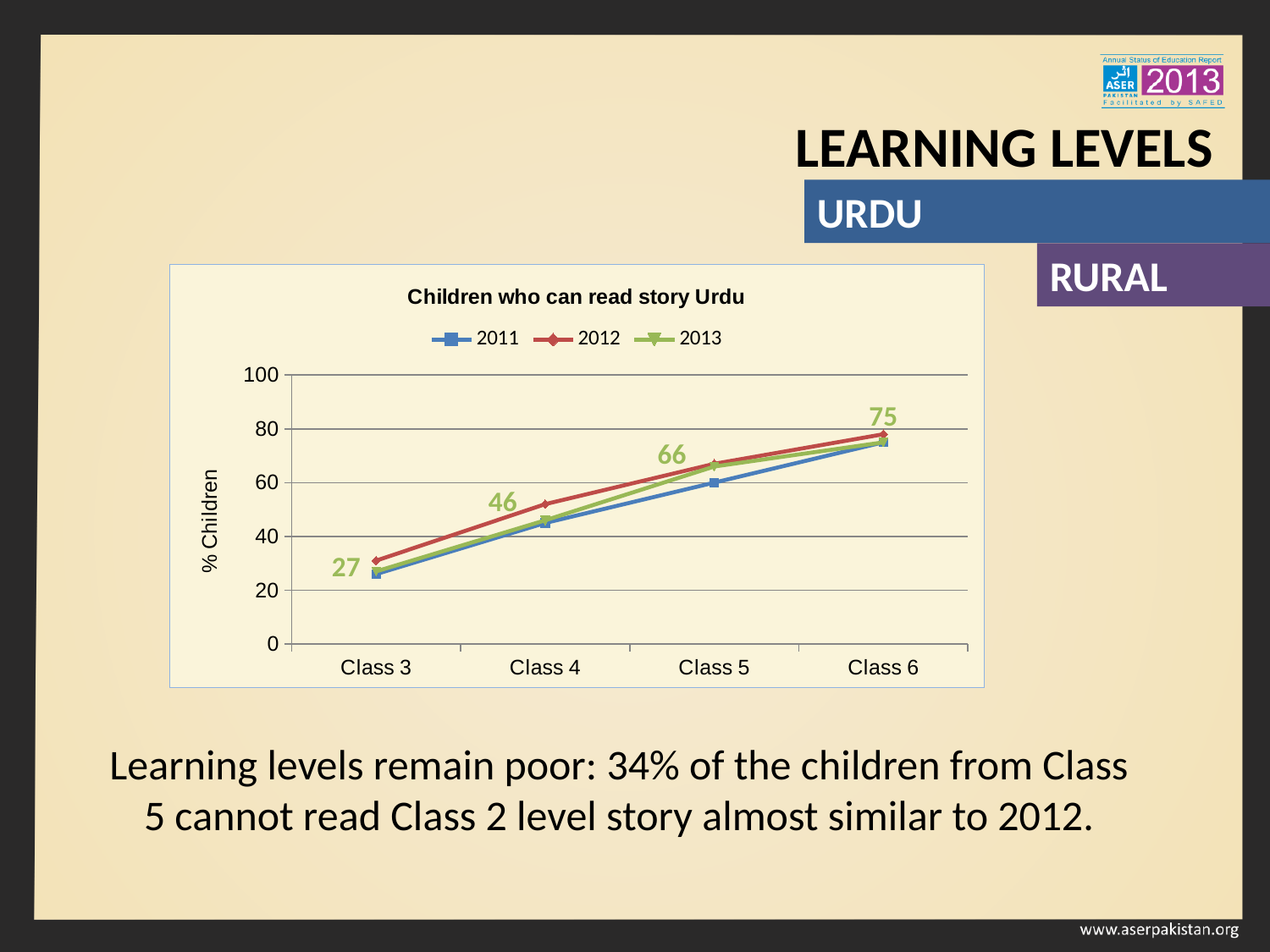
What is the value for Class 3 in the 2013 series? 27 What is the value for Class 6 in the 2013 series? 75 Is the value for Class 3 in the 2011 series greater or less than 40? less Which class has the lowest value in the 2013 series? Class 3 What is the difference between the 2013 values for Class 5 and Class 4? 20 How many series does the legend list? 3 What kind of chart is shown on the slide? line chart Is the value for Class 6 in the 2012 series greater or less than 60? greater Which class has the highest value in the 2013 series? Class 6 What is the value for Class 5 in the 2013 series? 66 What is the difference between the 2013 values for Class 6 and Class 3? 48 How many classes are shown on the x axis? 4